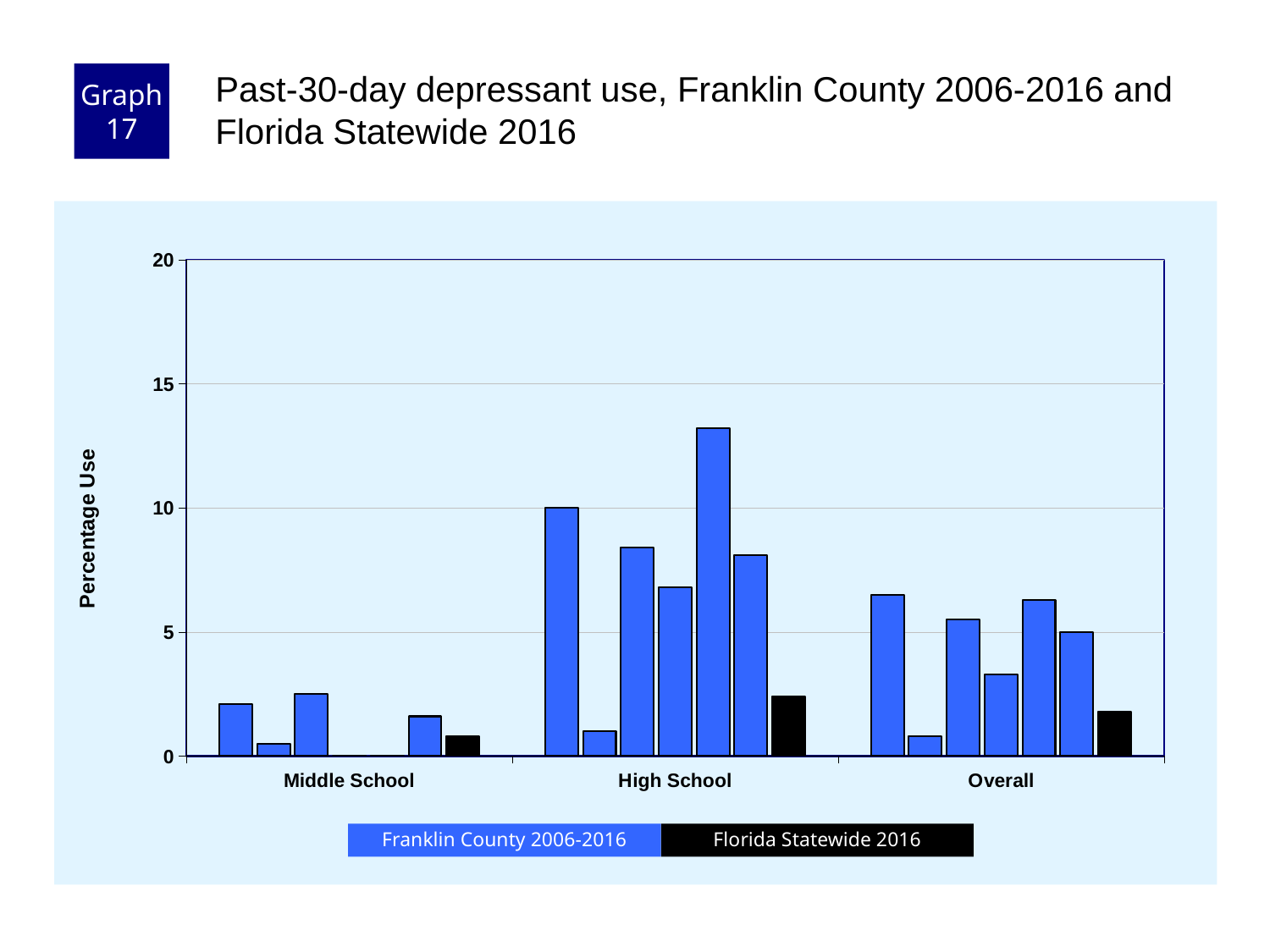
Which is larger, the Florida Statewide 2016 value for High School or for Overall? High School Which category contains the tallest Franklin County 2006-2016 bar? High School Which category has the tallest Florida Statewide 2016 bar? High School What colour represents Florida Statewide 2016 in the legend? black Is the Florida Statewide 2016 value for Overall greater or less than 5? less How many series does the legend list? 2 Which category has the shortest Florida Statewide 2016 bar? Middle School What kind of chart is shown on the slide? bar chart Is the Florida Statewide 2016 value for High School greater or less than 5? less Is the tallest Franklin County bar in the High School group greater or less than 10? greater What is the label on the y axis? Percentage Use How many school-level categories are shown on the x axis? 3